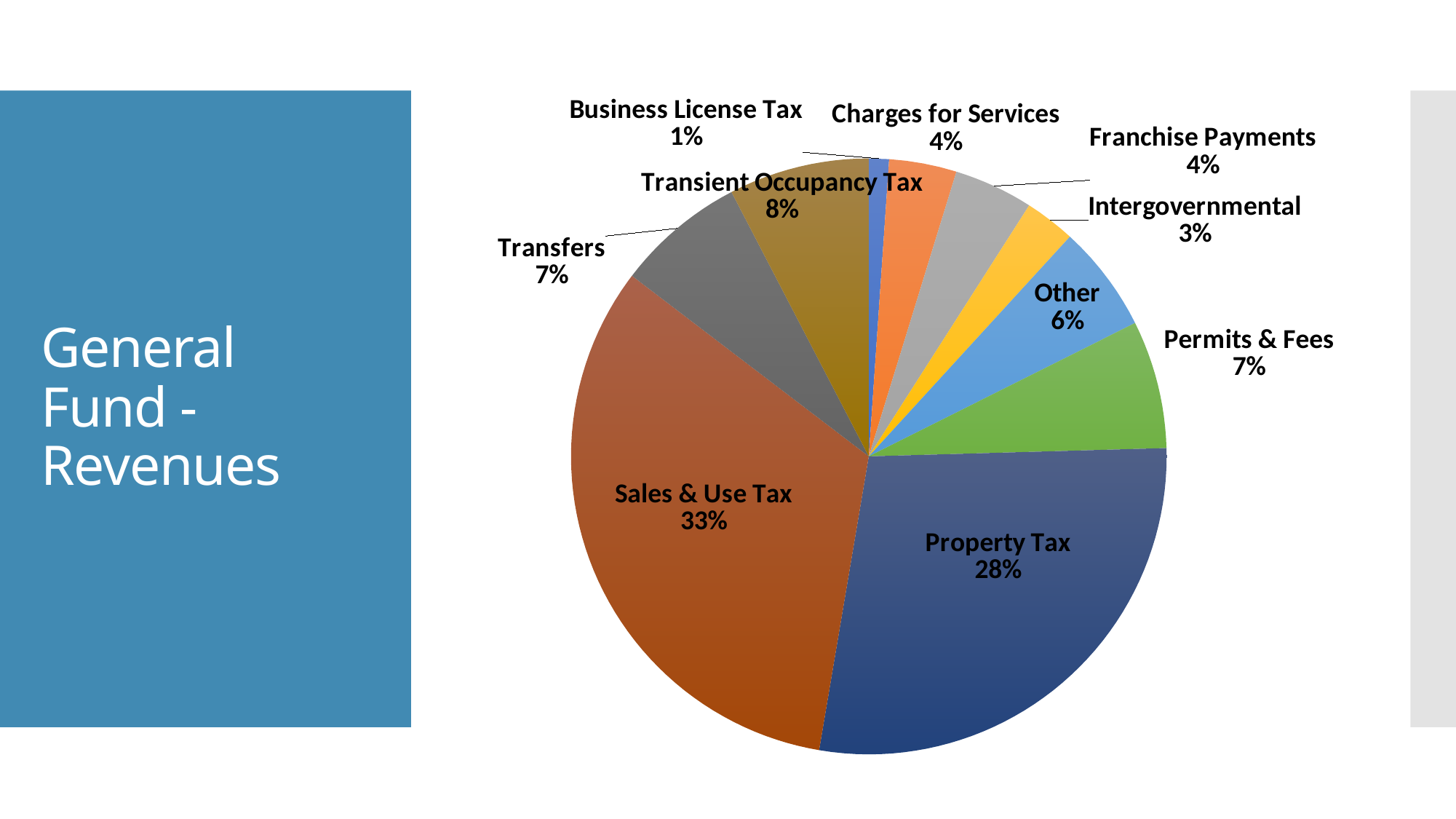
Which is larger, Transient Occupancy Tax or Other? Transient Occupancy Tax How many categories are shown in the pie chart? 10 What is the title of the slide containing the chart? General Fund - Revenues What is the value shown for Intergovernmental? 3% What share of the pie does Property Tax represent? 28% What is the value shown for Transient Occupancy Tax? 8% What share of the pie does Sales & Use Tax represent? 33% Which category has the largest slice of the pie? Sales & Use Tax Which category has the smallest slice of the pie? Business License Tax What kind of chart is shown on the slide? Pie chart What is the value shown for Permits & Fees? 7% What is the difference in percentage points between Sales & Use Tax and Property Tax? 5